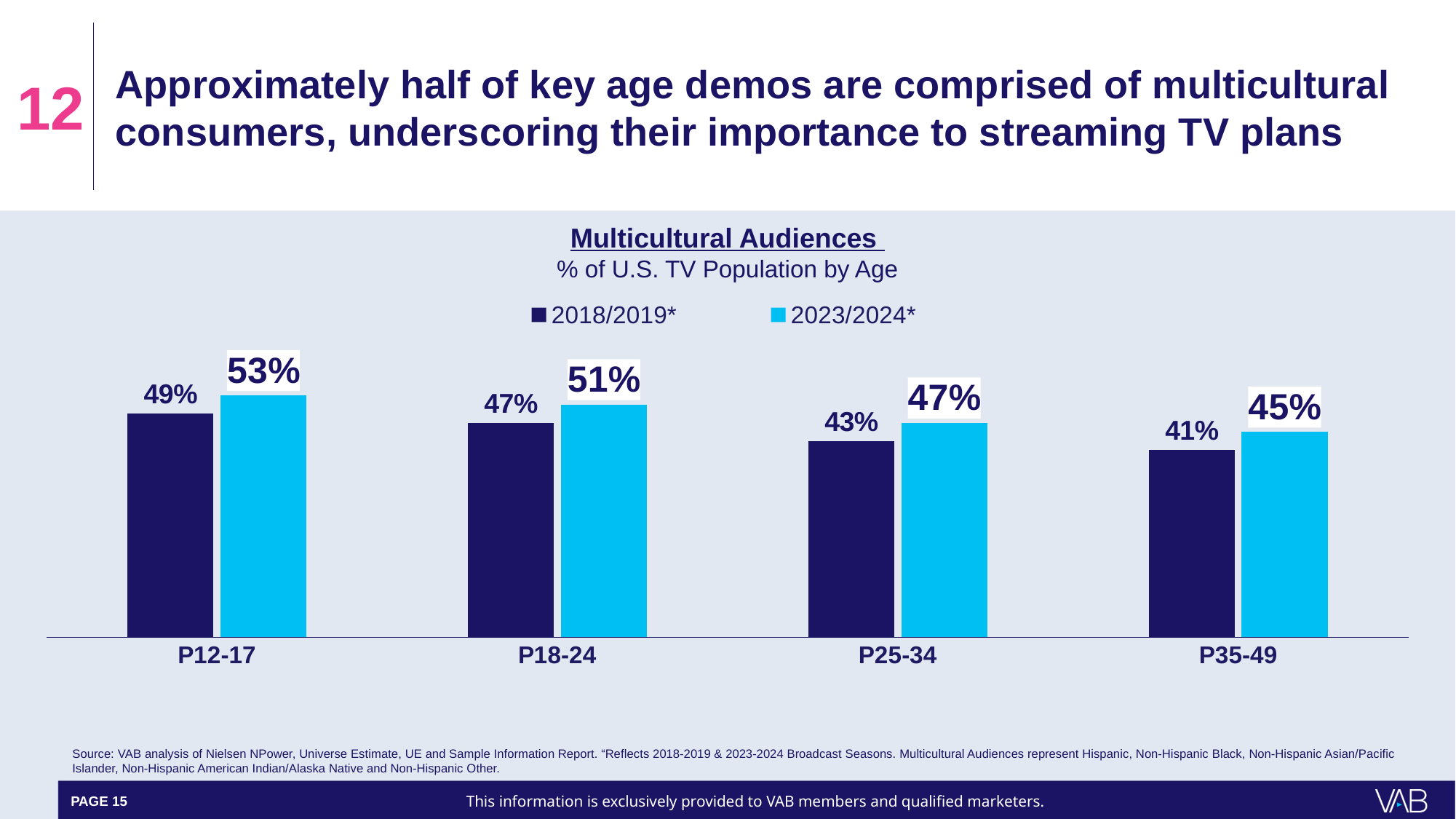
How many age groups are shown on the x axis? 4 How many series does the legend list? 2 Which age group has the lowest 2018/2019* value? P35-49 What is the 2023/2024* value for P35-49? 45% Which age group has the highest 2023/2024* value? P12-17 What is the 2023/2024* value for P12-17? 53% What is the 2018/2019* value for P25-34? 43% What is the difference between the 2023/2024* values for P12-17 and P35-49? 8 percentage points Which is larger for P25-34: the 2018/2019* value or the 2023/2024* value? 2023/2024* What kind of chart is shown on the slide? Bar chart What is the difference between the 2023/2024* and 2018/2019* values for P18-24? 4 percentage points Do the 2023/2024* values rise or fall from P12-17 to P35-49? Fall